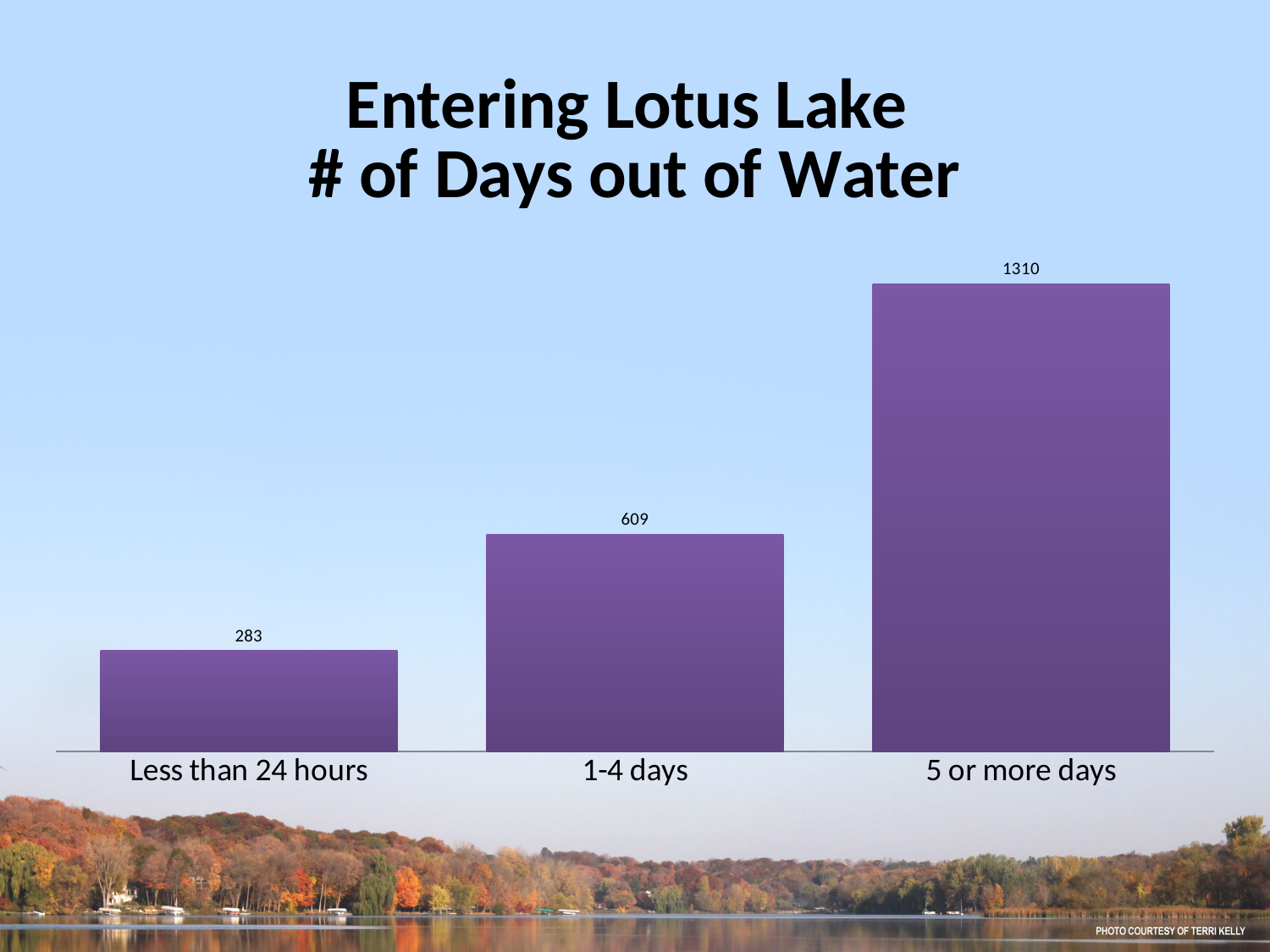
Which is larger, the value for "1-4 days" or the value for "Less than 24 hours"? 1-4 days How many categories are shown on the chart? 3 Which category has the lowest value? Less than 24 hours What is the value for "Less than 24 hours"? 283 What is the difference between the values for "5 or more days" and "1-4 days"? 701 What is the title of the chart? Entering Lotus Lake # of Days out of Water What is the value for "5 or more days"? 1310 Do the values rise or fall from left to right along the x axis? rise What is the difference between the values for "1-4 days" and "Less than 24 hours"? 326 What kind of chart is shown on the slide? bar chart Which category has the highest value? 5 or more days What is the value for "1-4 days"? 609